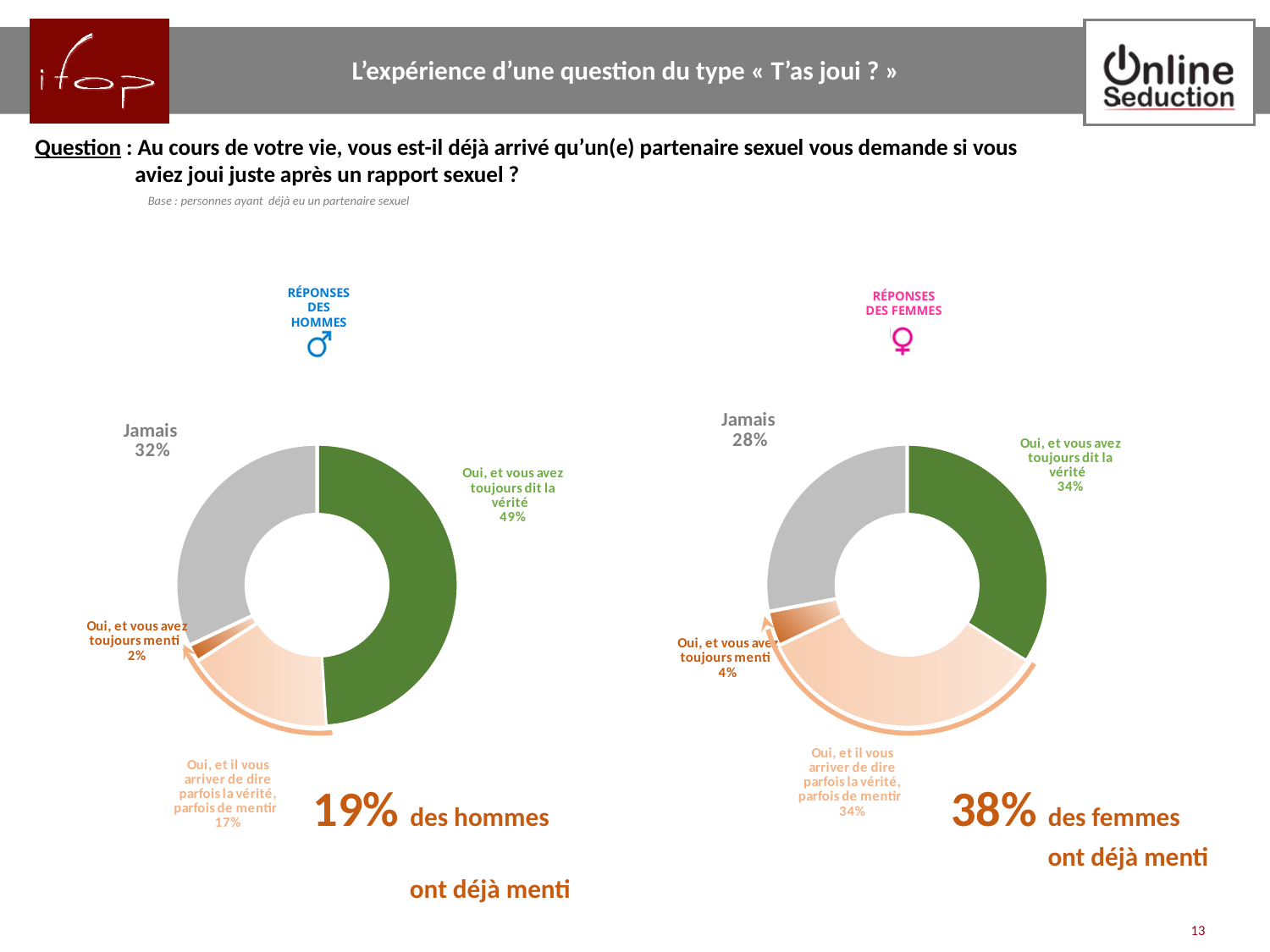
In the 'Réponses des hommes' chart, which response has the largest share? Oui, et vous avez toujours dit la vérité According to the slide, what percentage of women have already lied ('ont déjà menti')? 38% In the 'Réponses des hommes' chart, what colour is the 'Jamais' segment? Grey What type of chart is used to show the men's and women's responses? Donut (pie) chart Which is larger: the 'Oui, et vous avez toujours dit la vérité' share for men or for women? Men (49%) In the 'Réponses des femmes' chart, what share of women answered 'Oui, et il vous arriver de dire parfois la vérité, parfois de mentir'? 34% What is the difference between the 'Jamais' share in the men's chart and the 'Jamais' share in the women's chart? 4 percentage points In the 'Réponses des femmes' chart, what share of women answered 'Oui, et vous avez toujours dit la vérité'? 34% In the 'Réponses des hommes' chart, what share of men answered 'Oui, et vous avez toujours menti'? 2% How many response categories does each donut chart show? 4 In the 'Réponses des femmes' chart, which response has the smallest share? Oui, et vous avez toujours menti In the 'Réponses des hommes' chart, what share of men answered 'Jamais'? 32%